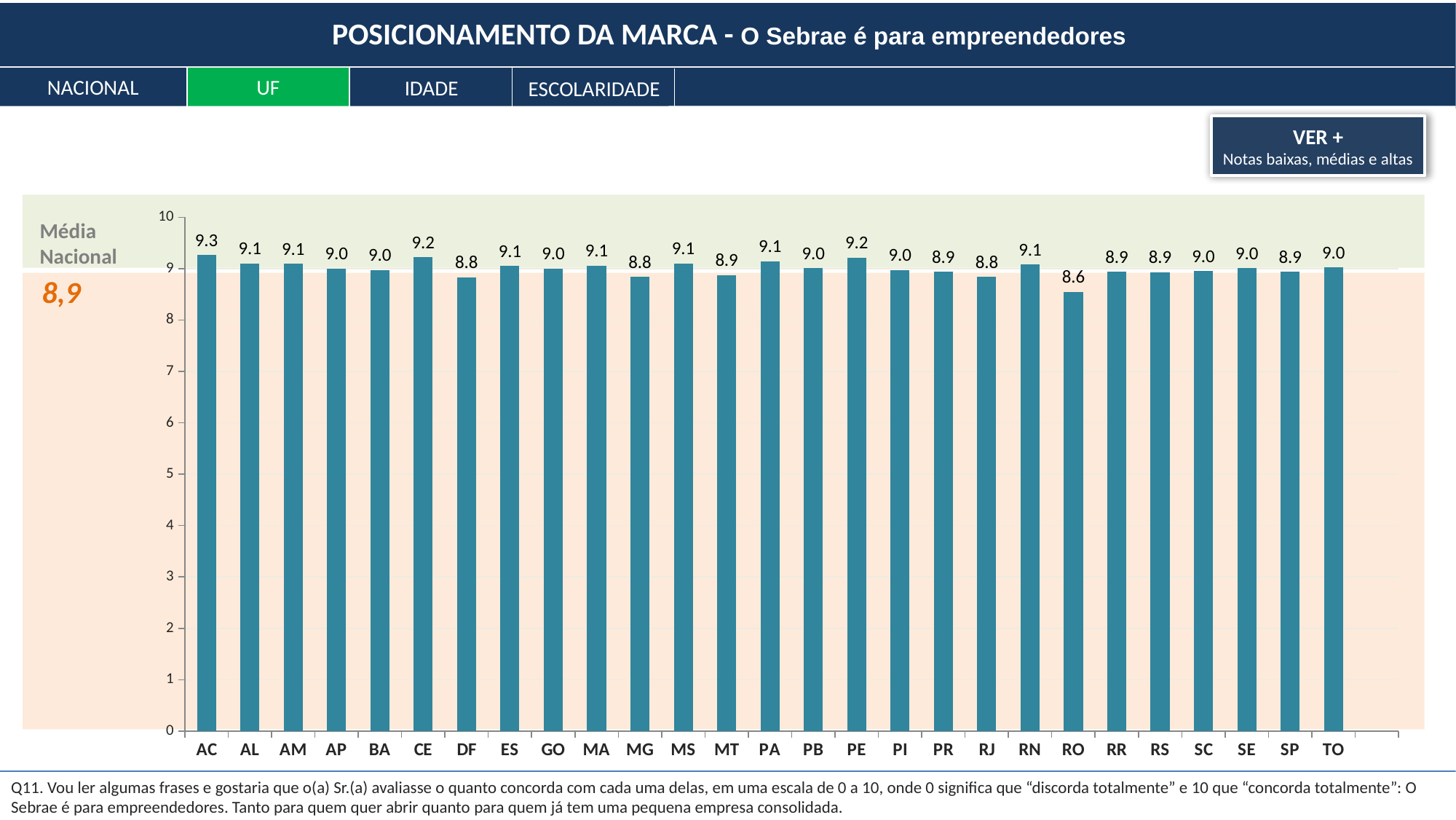
Is the value for RO greater or less than 9? less What is the difference between the values for AC and RO? 0.7 Which state has the highest value? AC What is the value for AC? 9.3 What is the value for PE? 9.2 What is the value for RO? 8.6 How many states (UFs) are shown on the x axis? 27 What kind of chart is shown on the slide? bar chart What is the national average (Média Nacional) shown on the chart? 8,9 Which is larger, the value for CE or the value for MG? CE What is the value for DF? 8.8 Which state has the lowest value? RO